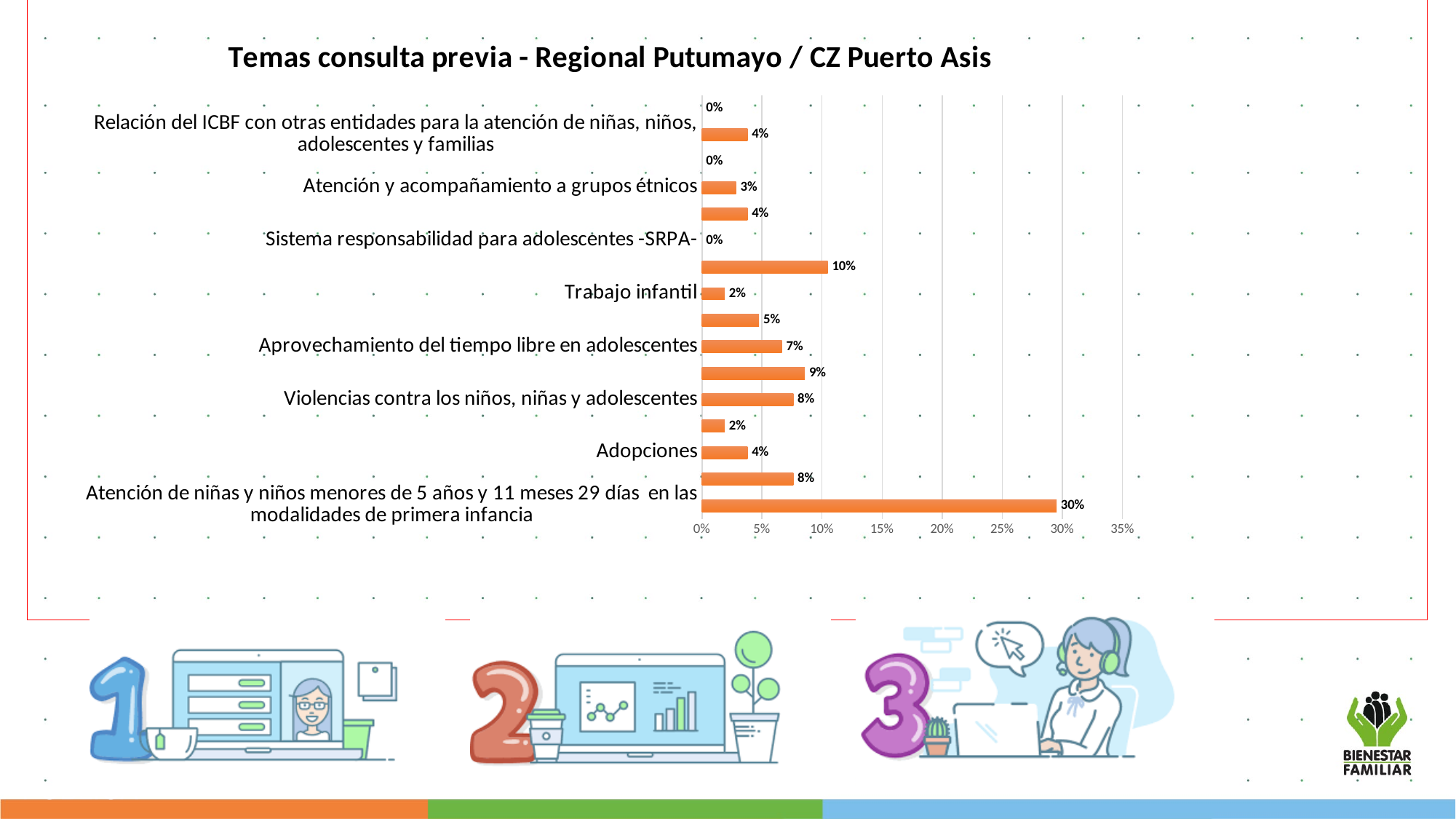
What is the value for 'Adopciones'? 4% What is the value for 'Sistema responsabilidad para adolescentes -SRPA-'? 0% What kind of chart is shown on the slide? Bar chart What is the highest value shown on the horizontal axis? 35% Which labeled category has the highest value? Atención de niñas y niños menores de 5 años y 11 meses 29 días en las modalidades de primera infancia What is the difference between the value for 'Atención de niñas y niños menores de 5 años y 11 meses 29 días en las modalidades de primera infancia' and the value for 'Violencias contra los niños, niñas y adolescentes'? 22 percentage points What is the title of the chart? Temas consulta previa - Regional Putumayo / CZ Puerto Asis What is the value for 'Violencias contra los niños, niñas y adolescentes'? 8% Which is larger: the value for 'Aprovechamiento del tiempo libre en adolescentes' or the value for 'Trabajo infantil'? Aprovechamiento del tiempo libre en adolescentes What is the value for 'Trabajo infantil'? 2% What is the value for 'Atención de niñas y niños menores de 5 años y 11 meses 29 días en las modalidades de primera infancia'? 30% What is the value for 'Atención y acompañamiento a grupos étnicos'? 3%